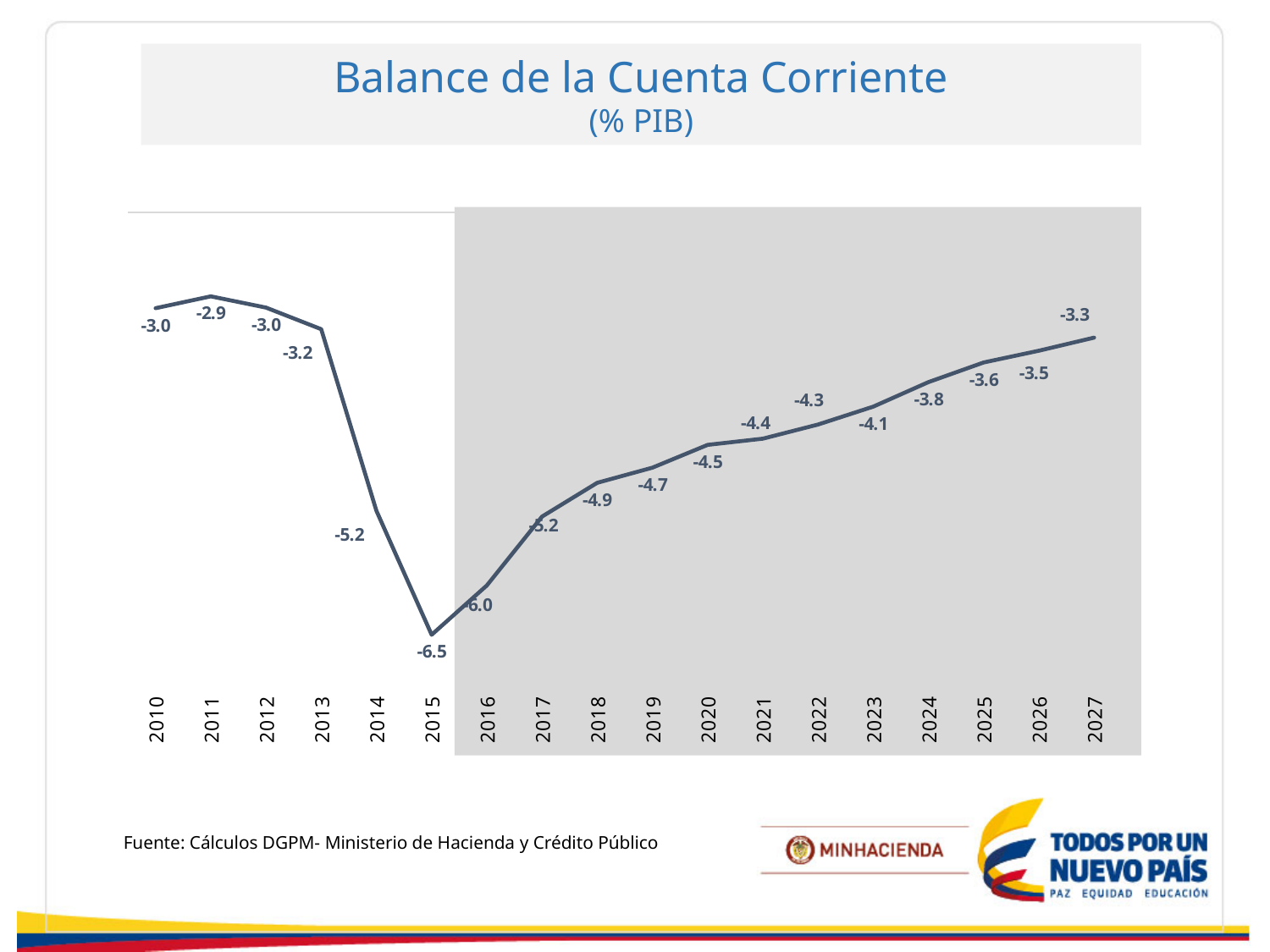
Which year has the lowest value? 2015 What is the value for 2015? -6.5 What kind of chart is shown? Line chart What is the difference between the values for 2016 and 2015? 0.5 How many years are plotted on the chart? 18 Which is larger, the value for 2018 or the value for 2024? 2024 What is the value for 2014? -5.2 What is the difference between the values for 2013 and 2014? 2.0 Do the values rise or fall from 2015 to 2027? Rise What is the value for 2027? -3.3 What is the value for 2020? -4.5 Which year has the highest value? 2011